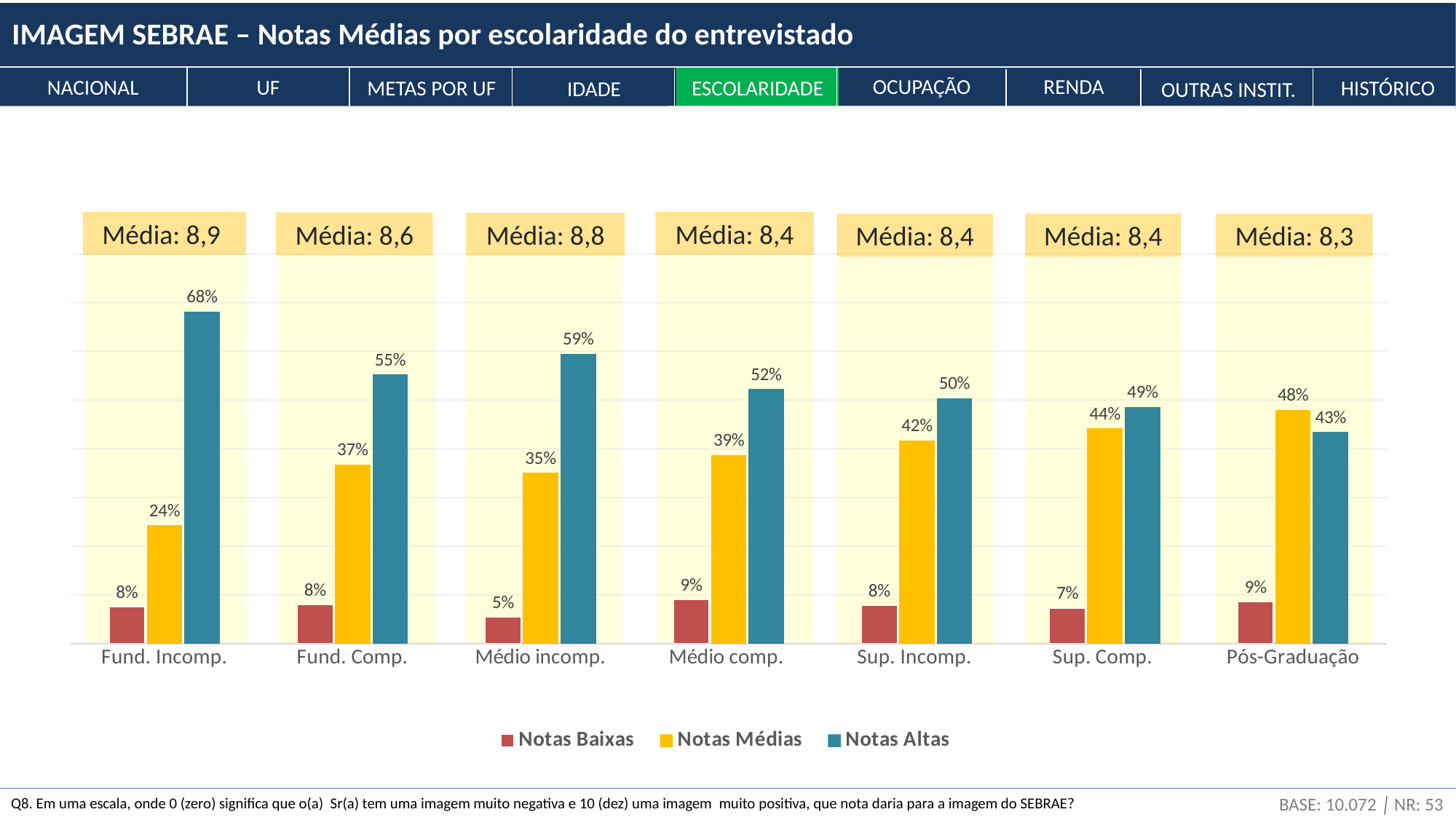
What is the value of Notas Altas for Fund. Incomp.? 68% Which is larger for Pós-Graduação: Notas Médias or Notas Altas? Notas Médias How many education level categories are shown on the x axis? 7 What is the value of Notas Baixas for Médio incomp.? 5% How many series does the legend list? 3 What is the Média shown above the Fund. Incomp. group? 8,9 Which education level has the lowest Notas Baixas value? Médio incomp. What kind of chart is shown on the slide? Bar chart What is the value of Notas Médias for Sup. Comp.? 44% Which education level has the highest Notas Altas value? Fund. Incomp. Do the Notas Altas values generally rise or fall from Fund. Incomp. to Pós-Graduação? Fall What is the difference between Notas Altas and Notas Médias for Médio comp.? 13%